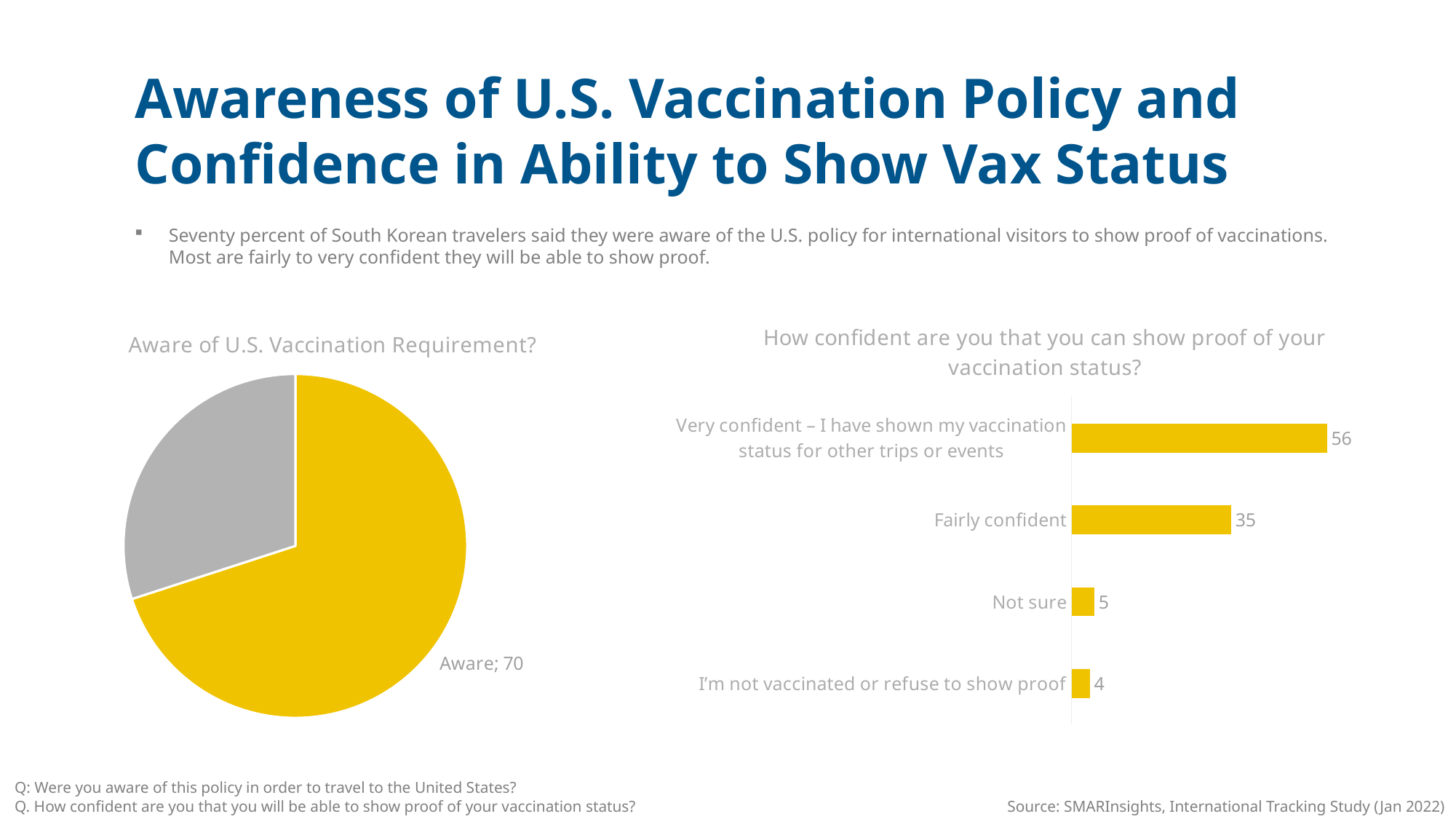
In the 'How confident are you that you can show proof of your vaccination status?' chart, what is the value for Not sure? 5 What kind of chart is the 'Aware of U.S. Vaccination Requirement?' chart? pie chart In the 'How confident are you that you can show proof of your vaccination status?' chart, what is the value for Fairly confident? 35 In the 'Aware of U.S. Vaccination Requirement?' chart, what value is shown for the Aware slice? 70 What kind of chart is the 'How confident are you that you can show proof of your vaccination status?' chart? bar chart In the 'How confident are you that you can show proof of your vaccination status?' chart, what is the value for 'I'm not vaccinated or refuse to show proof'? 4 In the 'How confident are you that you can show proof of your vaccination status?' chart, which is larger: Fairly confident or Not sure? Fairly confident In the 'How confident are you that you can show proof of your vaccination status?' chart, what is the difference between the Very confident value and the Fairly confident value? 21 In the 'How confident are you that you can show proof of your vaccination status?' chart, which category has the highest value? Very confident – I have shown my vaccination status for other trips or events How many categories are shown in the 'How confident are you that you can show proof of your vaccination status?' chart? 4 What colour are the bars in the 'How confident are you that you can show proof of your vaccination status?' chart? yellow In the 'How confident are you that you can show proof of your vaccination status?' chart, which category has the lowest value? I'm not vaccinated or refuse to show proof